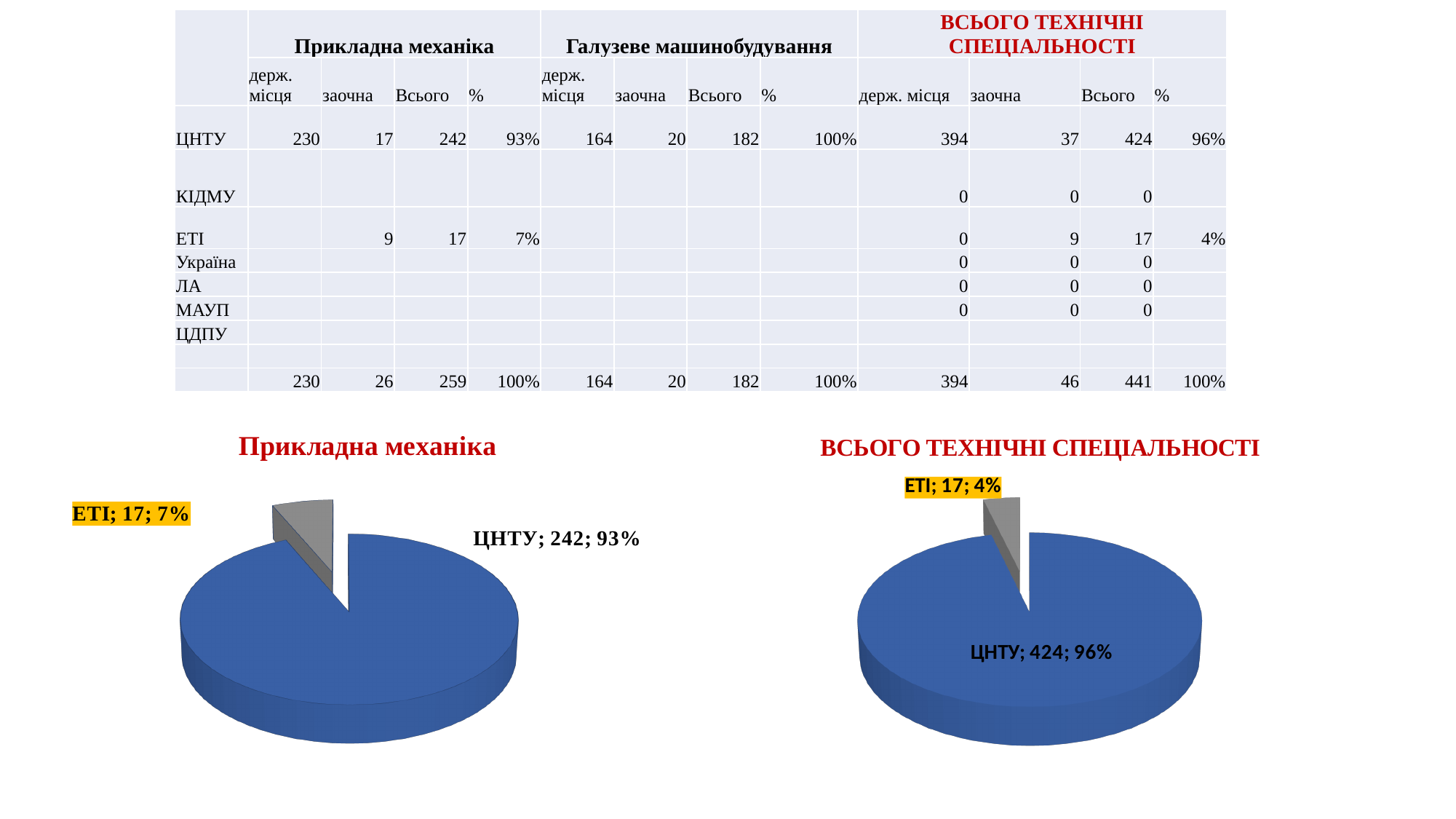
In the 'Прикладна механіка' pie chart, which category has the largest slice? ЦНТУ In the 'Прикладна механіка' pie chart, what is the difference between the values for ЦНТУ and ЕТІ? 225 In the 'ВСЬОГО ТЕХНІЧНІ СПЕЦІАЛЬНОСТІ' pie chart, what value is shown for ЕТІ? 17 In the 'ВСЬОГО ТЕХНІЧНІ СПЕЦІАЛЬНОСТІ' pie chart, which category has the smallest slice? ЕТІ In the 'Прикладна механіка' pie chart, what colour is the ЦНТУ slice? Blue What type of chart is the 'ВСЬОГО ТЕХНІЧНІ СПЕЦІАЛЬНОСТІ' chart? Pie chart In the 'Прикладна механіка' pie chart, what value is shown for ЦНТУ? 242 In the 'ВСЬОГО ТЕХНІЧНІ СПЕЦІАЛЬНОСТІ' pie chart, what is the difference between the values for ЦНТУ and ЕТІ? 407 In the 'ВСЬОГО ТЕХНІЧНІ СПЕЦІАЛЬНОСТІ' pie chart, what value is shown for ЦНТУ? 424 In the 'ВСЬОГО ТЕХНІЧНІ СПЕЦІАЛЬНОСТІ' pie chart, what share of the pie does ЦНТУ have? 96% In the 'Прикладна механіка' pie chart, what share of the pie does ЕТІ have? 7% How many slices does the 'Прикладна механіка' pie chart have? 2